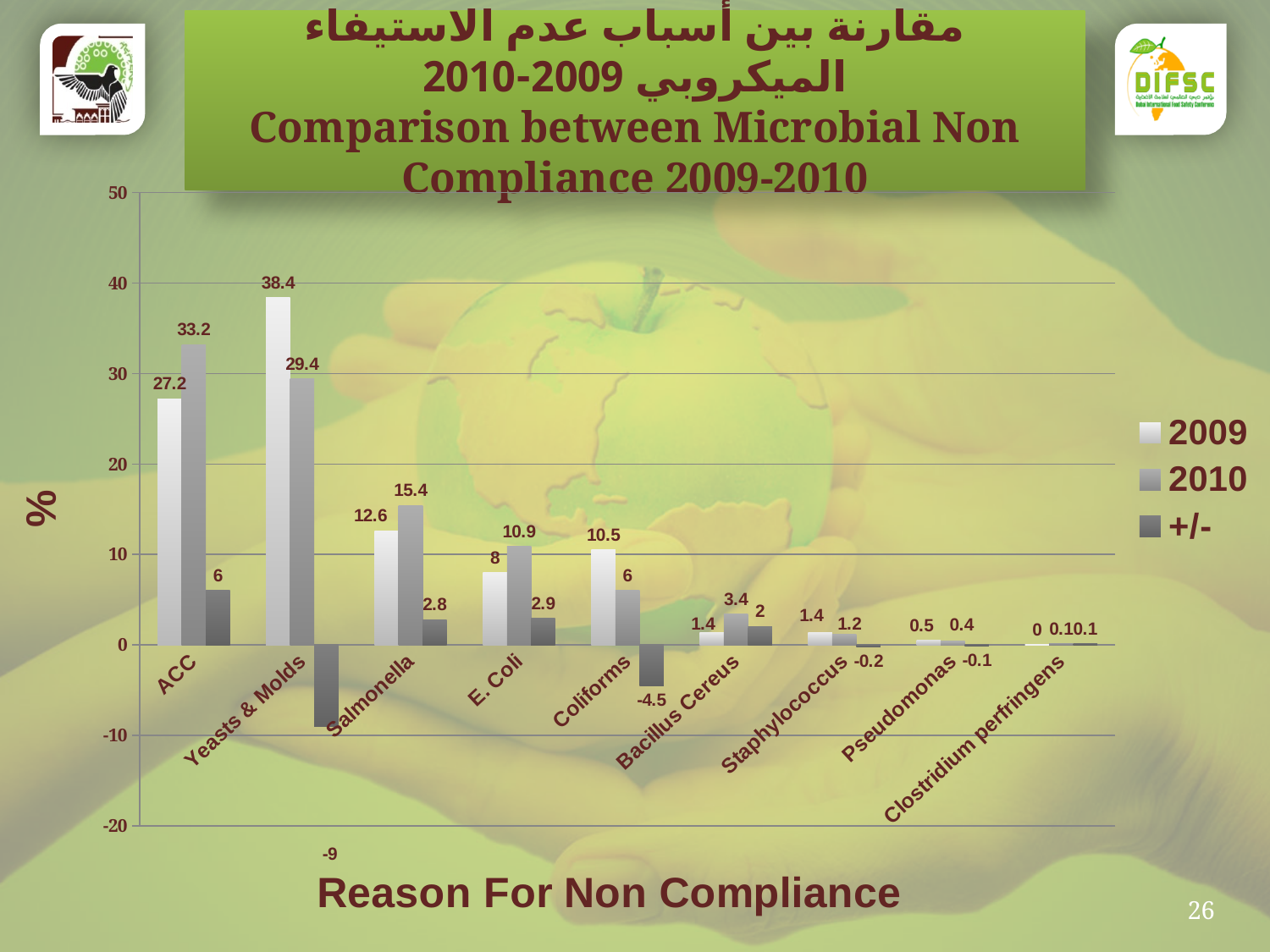
How many reasons for non compliance are shown on the x axis? 9 What type of chart is shown on the slide? bar chart What is the difference between the 2010 and 2009 values for Salmonella? 2.8 What is the +/- value for Coliforms? -4.5 Which reason for non compliance has the lowest +/- value? Yeasts & Molds How many series does the legend list? 3 What is the 2009 value for Yeasts & Molds? 38.4 What is the 2010 value for ACC? 33.2 What is the label of the y axis? % Which reason for non compliance has the highest 2010 value? ACC What is the 2009 value for Clostridium perfringens? 0 Which is larger for E. Coli, the 2009 value or the 2010 value? 2010